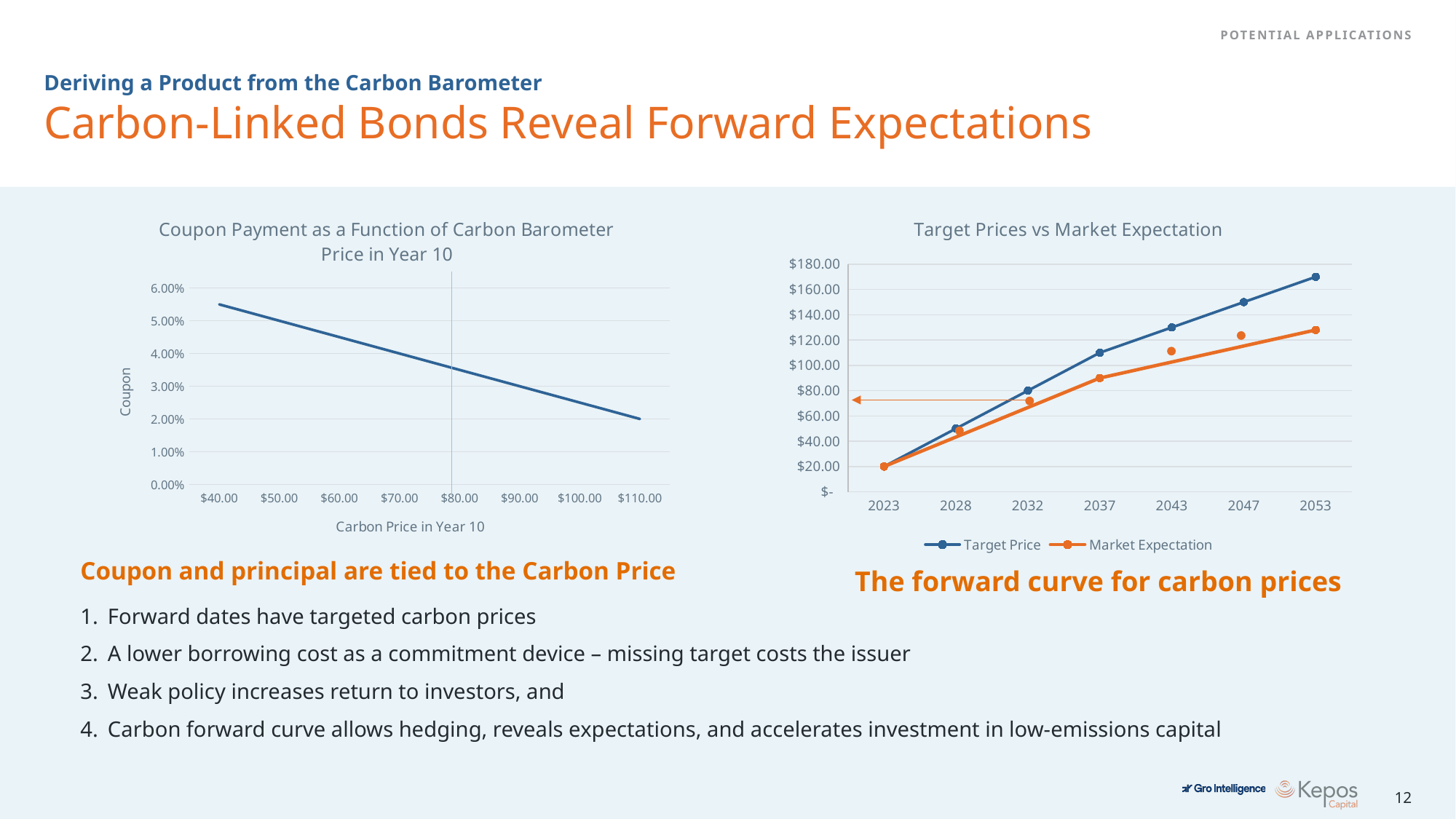
In the 'Target Prices vs Market Expectation' chart, is the Target Price for 2053 greater or less than $160.00? greater In the 'Coupon Payment as a Function of Carbon Barometer Price in Year 10' chart, is the coupon at a carbon price of $40.00 greater or less than 5.00%? greater In the 'Target Prices vs Market Expectation' chart, is the Market Expectation for 2053 greater or less than $140.00? less In the 'Target Prices vs Market Expectation' chart, which year has the highest Target Price? 2053 What kind of chart is the 'Target Prices vs Market Expectation' chart? line chart How many series does the legend of the 'Target Prices vs Market Expectation' chart list? 2 How many years are shown on the x axis of the 'Target Prices vs Market Expectation' chart? 7 In the 'Coupon Payment as a Function of Carbon Barometer Price in Year 10' chart, does the coupon rise or fall as the carbon price increases? fall In the 'Target Prices vs Market Expectation' chart, do the Target Price values rise or fall from 2023 to 2053? rise In the 'Target Prices vs Market Expectation' chart, which series is higher in 2047, Target Price or Market Expectation? Target Price What kind of chart is the 'Coupon Payment as a Function of Carbon Barometer Price in Year 10' chart? line chart